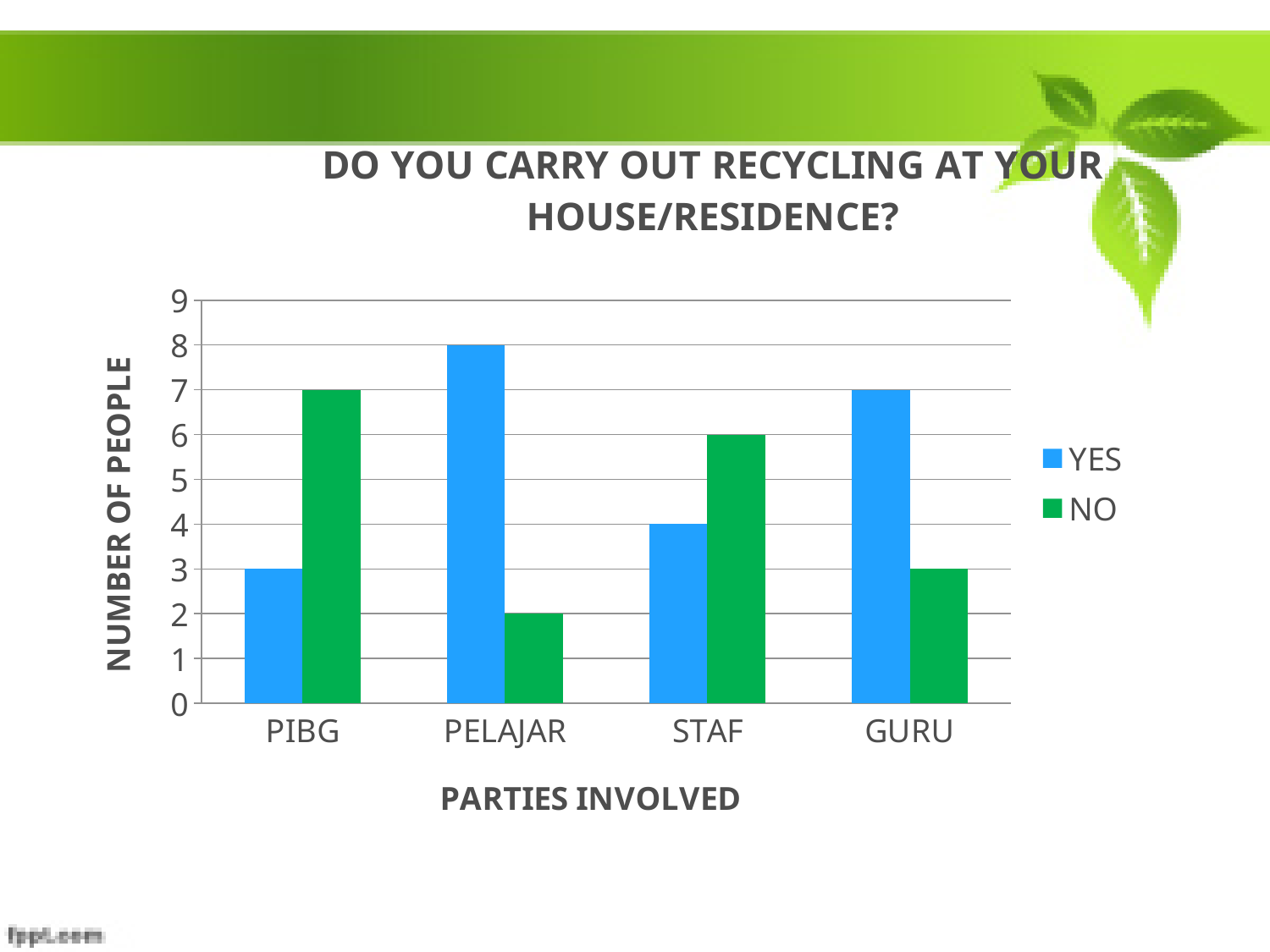
What is the NO value for GURU? 3 What kind of chart is shown on the slide? bar chart What is the difference between the YES and NO values for STAF? 2 Is the YES value for PIBG greater or less than 5? less How many parties are shown on the x axis? 4 Which party has the highest YES value? PELAJAR Which is larger for GURU, the YES value or the NO value? YES What is the YES value for STAF? 4 What is the YES value for PELAJAR? 8 What is the NO value for PIBG? 7 How many series does the legend list? 2 Which party has the lowest NO value? PELAJAR